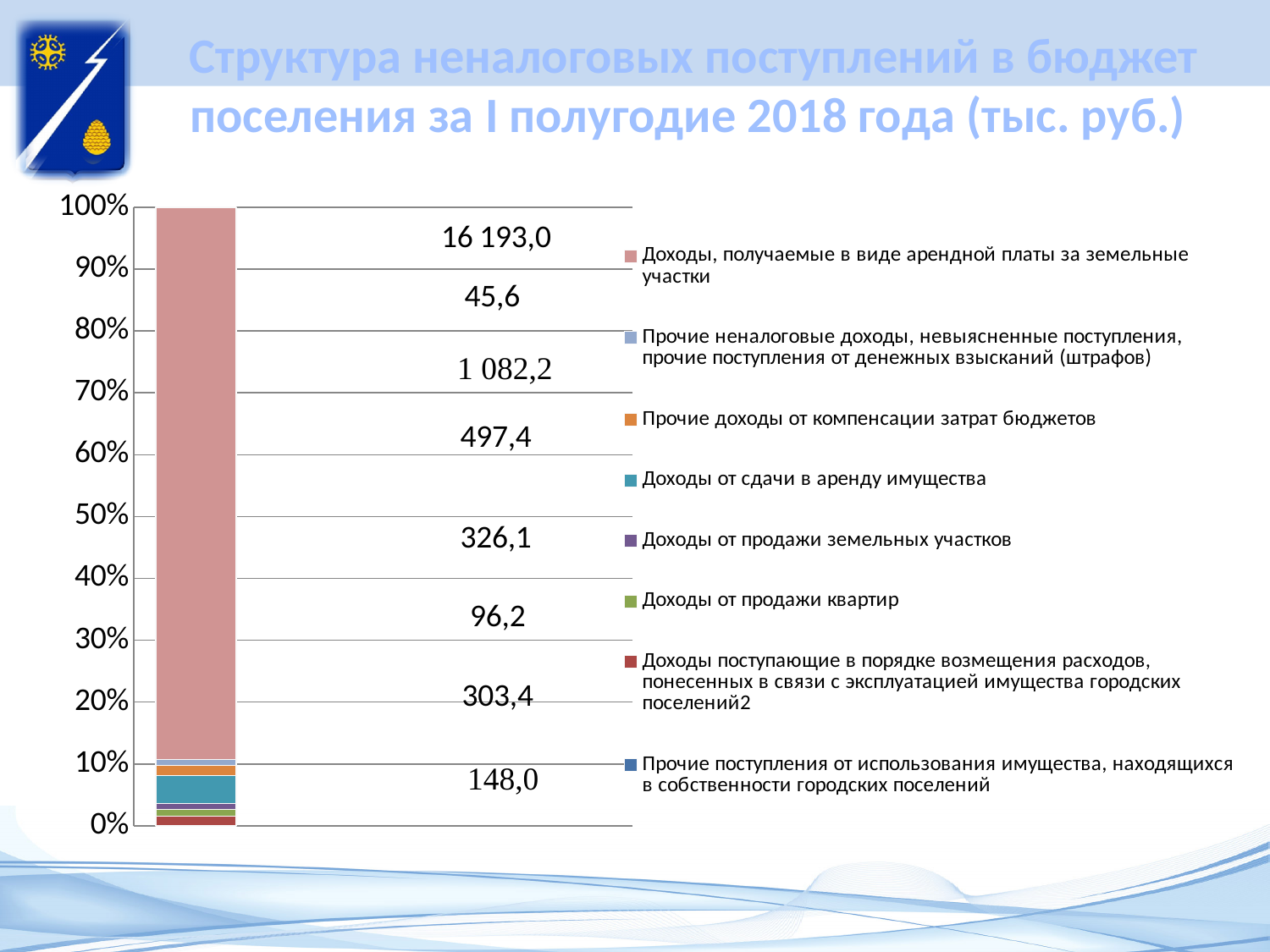
What is the difference between the largest and smallest values printed on the chart (16 193,0 and 45,6)? 16 147,4 What kind of chart is shown on the slide? Stacked bar chart Which series takes up the largest share of the bar? Доходы, получаемые в виде арендной платы за земельные участки How many series does the legend list? 8 What colour represents 'Доходы, получаемые в виде арендной платы за земельные участки' in the legend? Pink Is the share of the bar taken by 'Доходы, получаемые в виде арендной платы за земельные участки' greater or less than 80%? greater What is the smallest value printed on the chart? 45,6 What is the title of the slide? Структура неналоговых поступлений в бюджет поселения за I полугодие 2018 года (тыс. руб.) Which segment is larger: 'Доходы, получаемые в виде арендной платы за земельные участки' or 'Доходы от сдачи в аренду имущества'? Доходы, получаемые в виде арендной платы за земельные участки What is the largest value printed on the chart? 16 193,0 How many bars are plotted in the chart? 1 What is the highest tick shown on the vertical axis? 100%